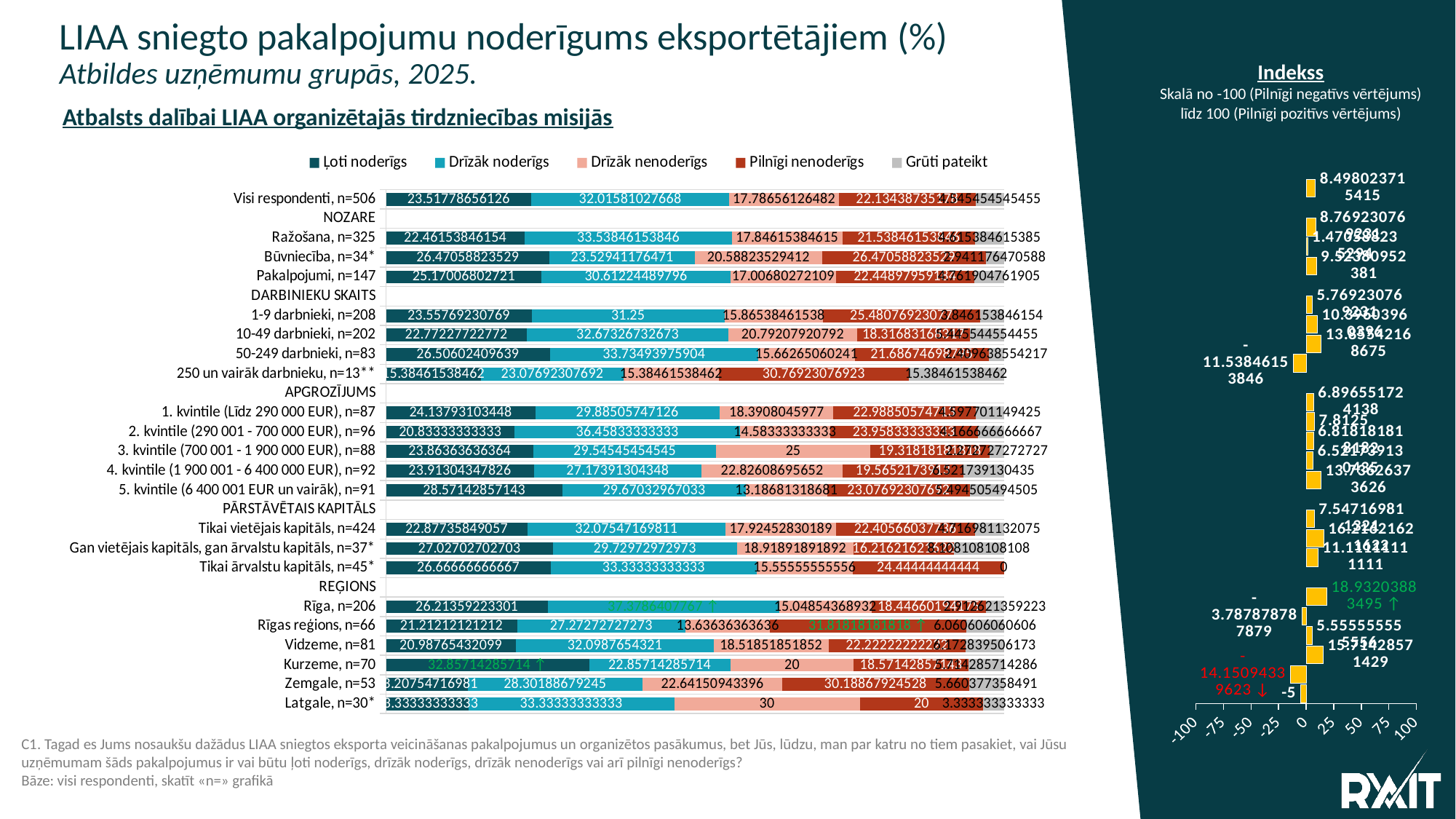
How many series does the legend of the stacked bar chart list? 5 In the stacked bar chart, what is the difference between the 'Drīzāk nenoderīgs' and 'Pilnīgi nenoderīgs' values for Latgale, n=30*? 10 In the stacked bar chart, what is the 'Drīzāk nenoderīgs' value for 3. kvintile (700 001 - 1 900 000 EUR), n=88? 25 In the Indekss chart on the right, what is the index value for Zemgale, n=53? -14.15094339623 In the stacked bar chart, what is the 'Pilnīgi nenoderīgs' value for Latgale, n=30*? 20 In the stacked bar chart, which group has the highest 'Ļoti noderīgs' value? Kurzeme, n=70 In the stacked bar chart, what is the 'Drīzāk noderīgs' value for 1-9 darbinieki, n=208? 31.25 What kind of chart is used to show the usefulness ratings by respondent group? Stacked bar chart In the stacked bar chart, what is the 'Drīzāk nenoderīgs' value for Latgale, n=30*? 30 In the stacked bar chart, what is the 'Grūti pateikt' value for Tikai ārvalstu kapitāls, n=45*? 0 In the stacked bar chart, which group has the highest 'Drīzāk noderīgs' value? Rīga, n=206 In the stacked bar chart, for Latgale, n=30*, which is larger: 'Drīzāk nenoderīgs' or 'Pilnīgi nenoderīgs'? Drīzāk nenoderīgs